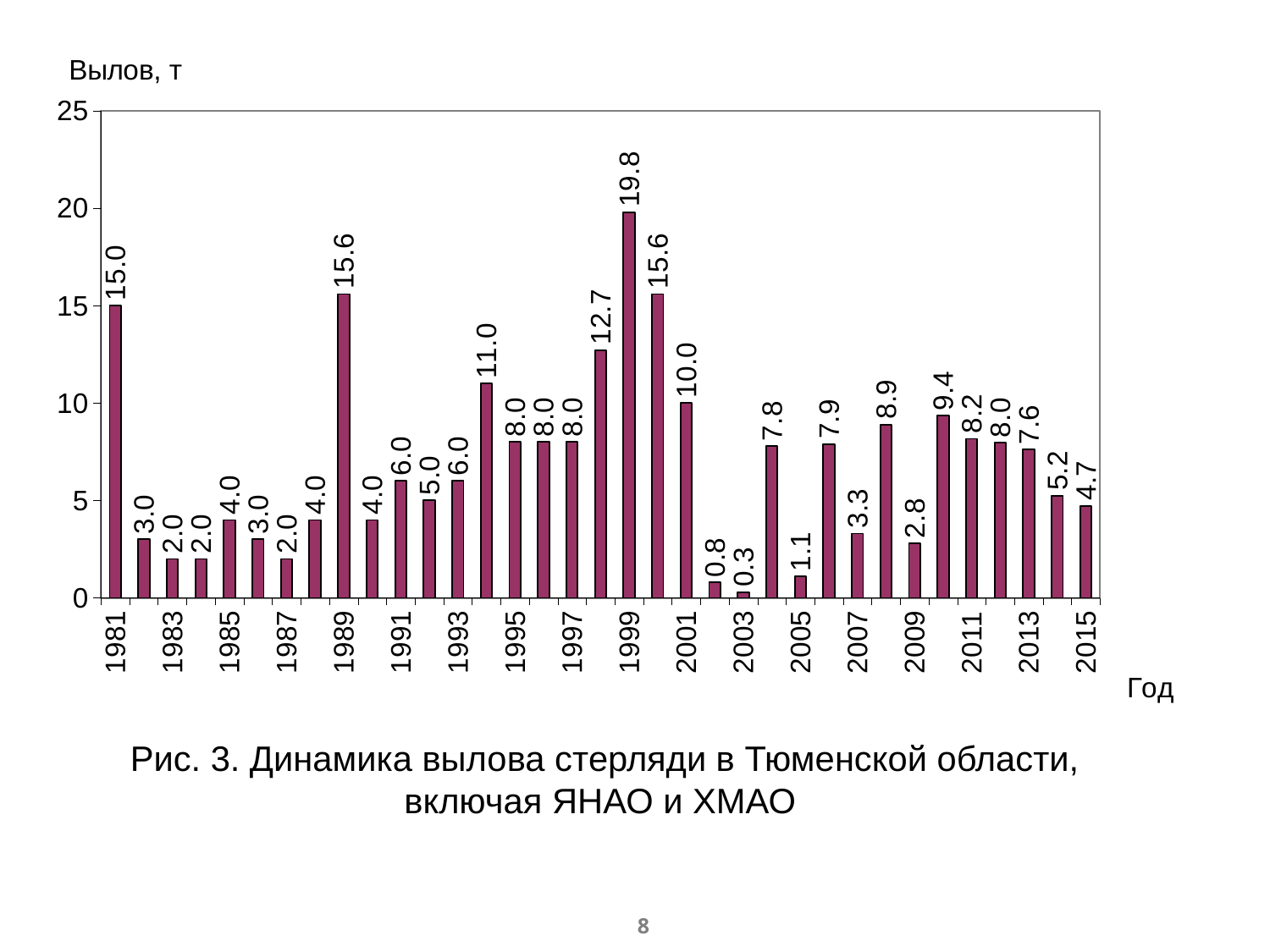
What type of chart is shown on the slide? bar chart What was the catch value in 2015? 4.7 Which year has the lowest catch? 2003 What was the sterlet catch (Вылов, т) in 1981? 15.0 Is the value for 1995 greater or less than 5? greater Which year has the highest catch? 1999 What is the label of the vertical axis? Вылов, т Which year had a larger catch, 1989 or 2001? 1989 How many bars are plotted in the chart? 35 What was the catch value in 1999? 19.8 What was the catch value in 2003? 0.3 What is the difference between the catch in 1999 and the catch in 1981? 4.8